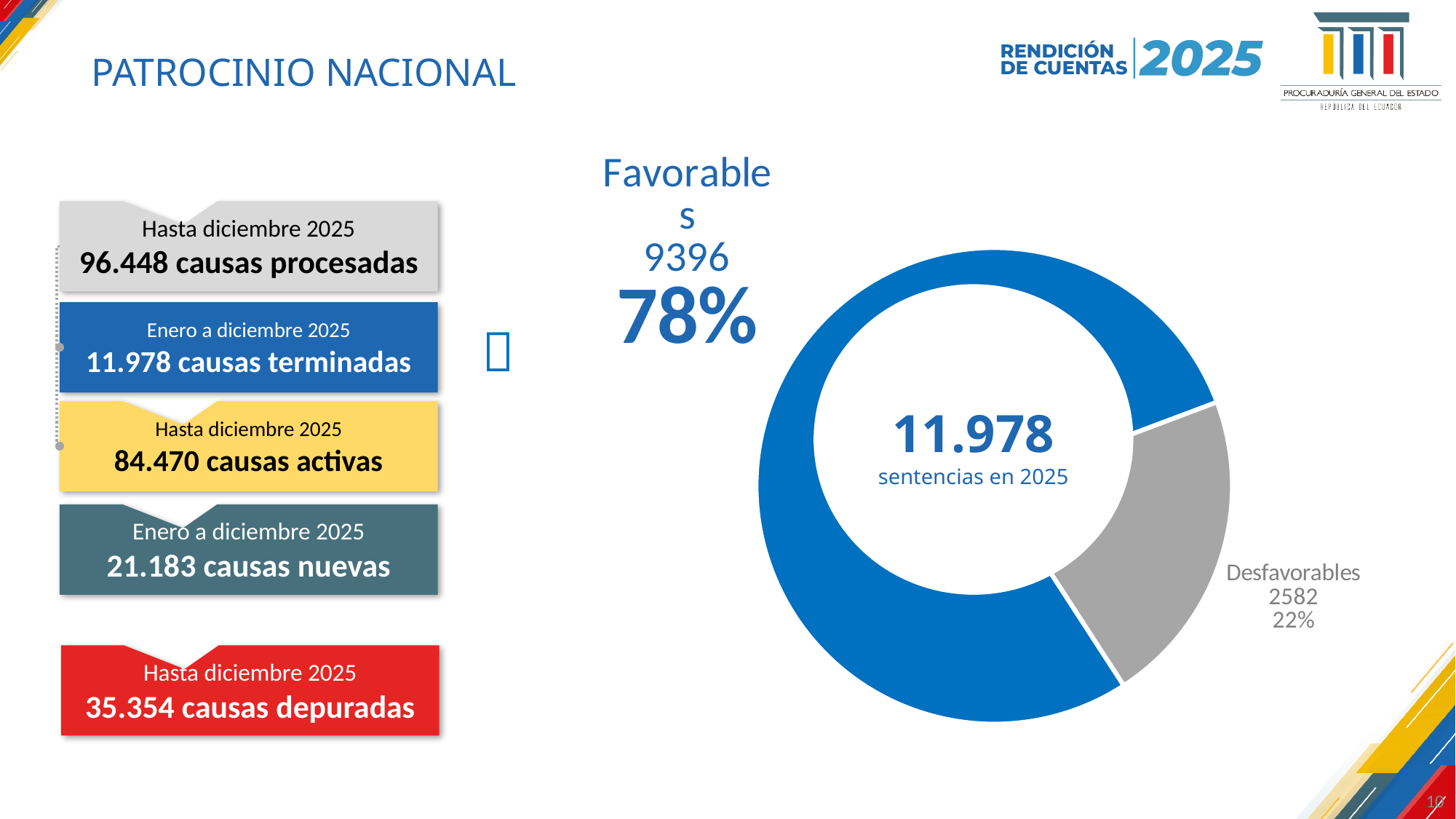
What total is shown in the centre of the donut chart? 11.978 sentencias en 2025 How many slices does the donut chart have? 2 What is the value for Desfavorables in the donut chart? 2582 Which is larger in the donut chart, Favorables or Desfavorables? Favorables What share of the donut chart is Favorables? 78% What colour is the Desfavorables slice of the donut chart? Grey Which slice of the donut chart is the smallest? Desfavorables What share of the donut chart is Desfavorables? 22% Which slice of the donut chart is the largest? Favorables What kind of chart is shown on the slide? Donut chart What is the difference between the Favorables and Desfavorables values in the donut chart? 6814 What is the value for Favorables in the donut chart? 9396